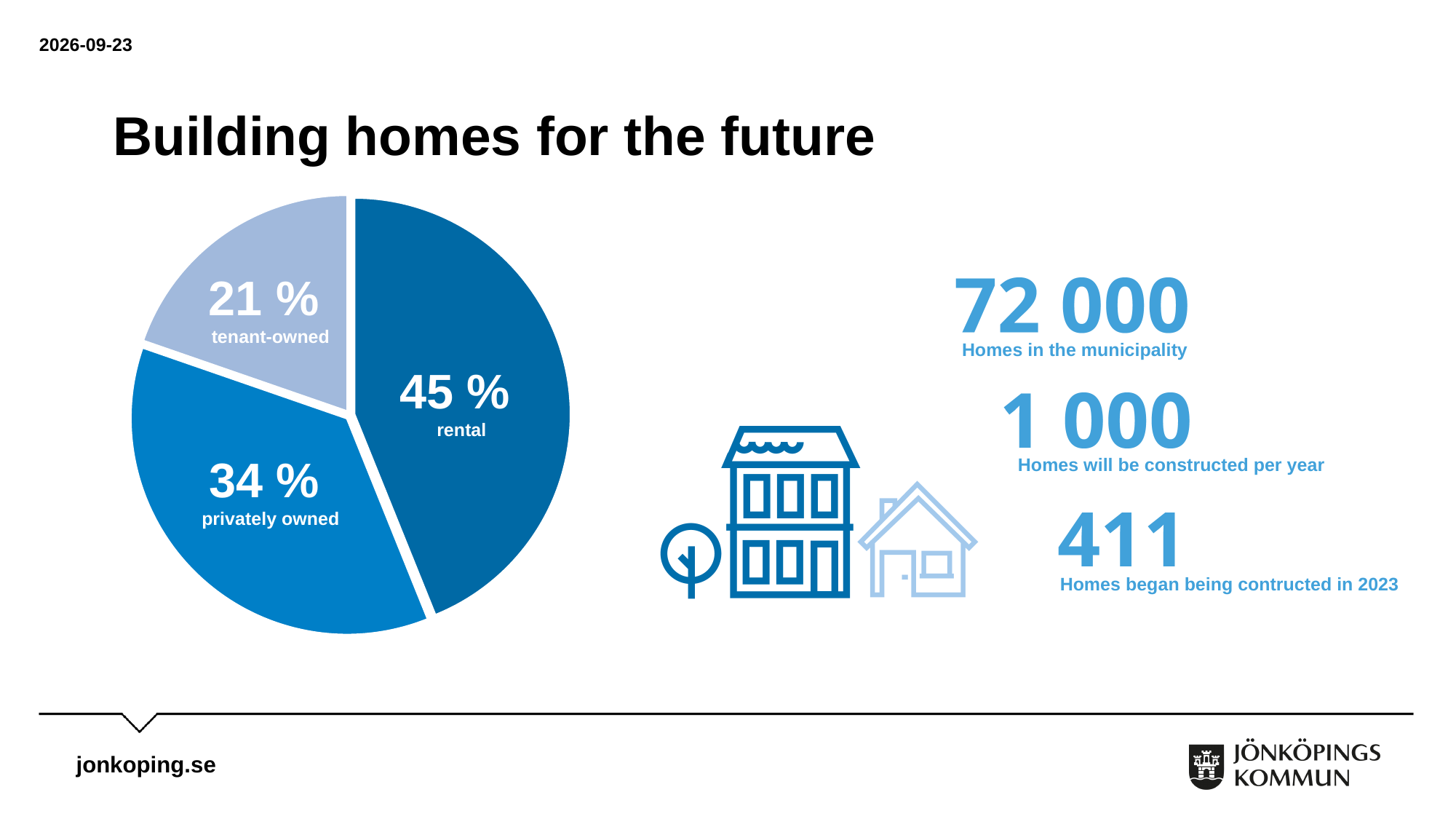
How many slices does the pie chart have? 3 What share of homes is rental according to the pie chart? 45 % Which slice is larger, privately owned or tenant-owned? privately owned Which category has the largest slice of the pie chart? rental What kind of chart is shown on the slide? pie chart What is the title of the slide containing the pie chart? Building homes for the future Which category has the smallest slice of the pie chart? tenant-owned What share of homes is tenant-owned according to the pie chart? 21 % What share of homes is privately owned according to the pie chart? 34 % What is the difference in percentage points between the rental and privately owned slices? 11 % What is the difference in percentage points between the privately owned and tenant-owned slices? 13 % Which slice of the pie chart is shown in the lightest blue colour? tenant-owned